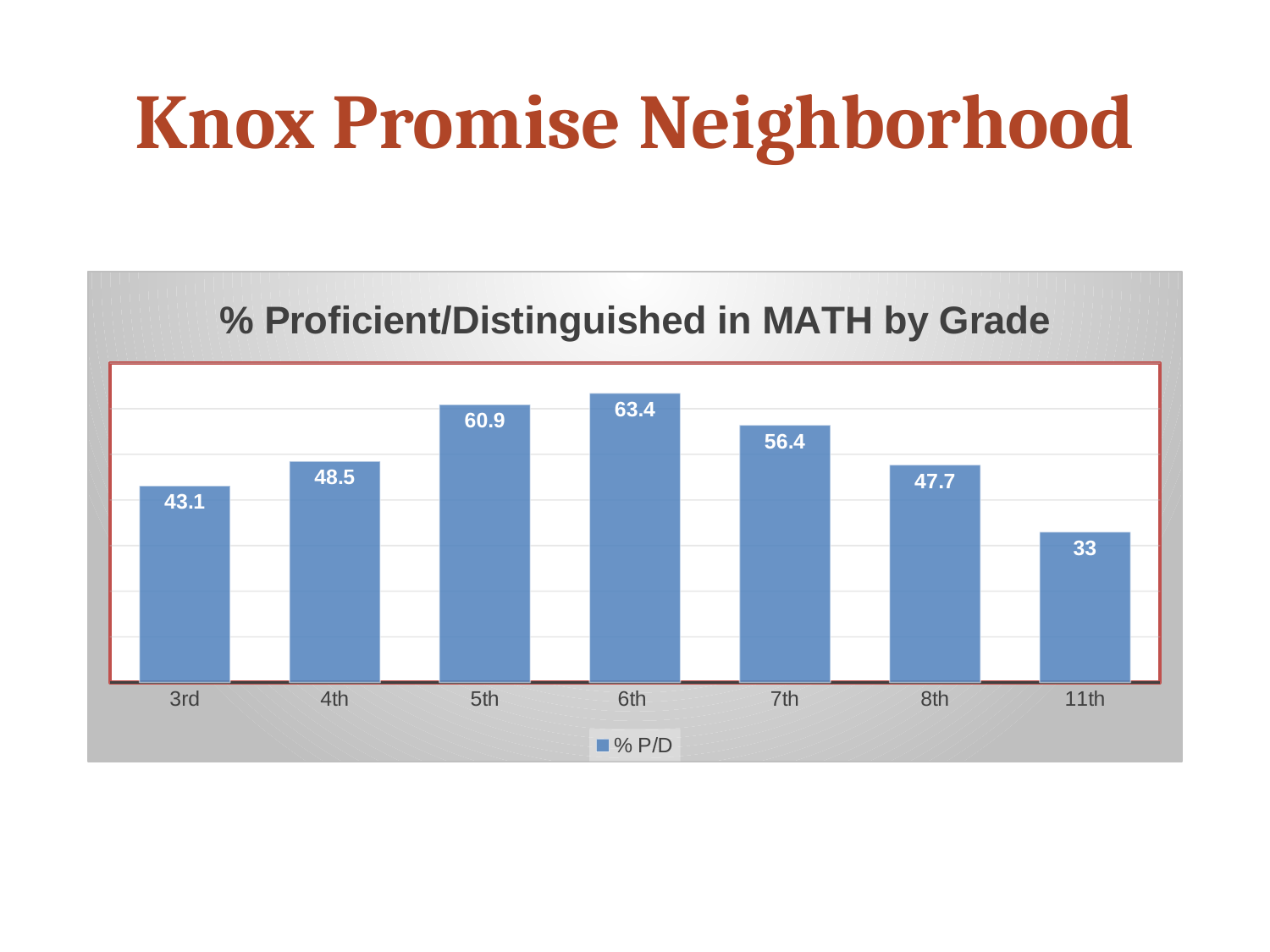
Which grade has the highest % Proficient/Distinguished in MATH? 6th What kind of chart is shown on the slide? Bar chart Do the values rise or fall from 6th grade to 11th grade? Fall How many series does the legend list? 1 Which grade has the lowest % Proficient/Distinguished in MATH? 11th What is the title of the chart? % Proficient/Distinguished in MATH by Grade How many grades are shown in the chart? 7 What is the % P/D value for 3rd grade? 43.1 What is the % P/D value for 11th grade? 33 What is the % P/D value for 5th grade? 60.9 Which has a higher value, 7th grade or 8th grade? 7th What is the difference between the values for 6th grade and 3rd grade? 20.3